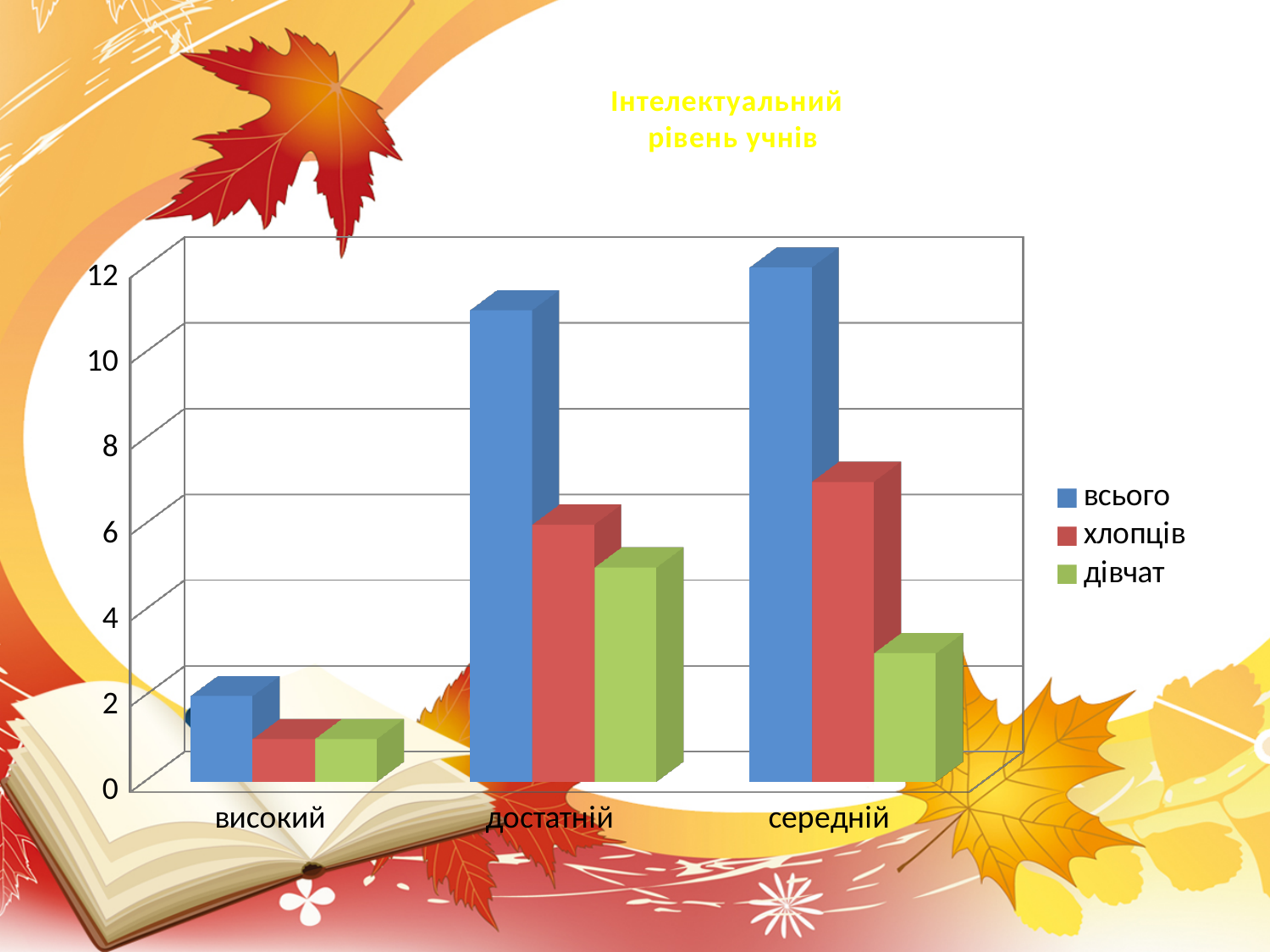
Which category has the highest value for the series "всього"? середній What is the title of the chart? Інтелектуальний рівень учнів How many series does the legend list? 3 Which category has the lowest value for the series "всього"? високий Is the value for "всього" in the category "достатній" greater or less than 10? greater Which is larger: the value for "хлопців" or for "дівчат" in the category "середній"? хлопців Which series is shown in green in the legend? дівчат How many categories are shown on the x axis? 3 Is the value for "дівчат" in the category "середній" greater or less than 4? less Is the value for "хлопців" in the category "середній" greater or less than 6? greater Which category has the lowest value for the series "дівчат"? високий What kind of chart is shown on the slide? bar chart